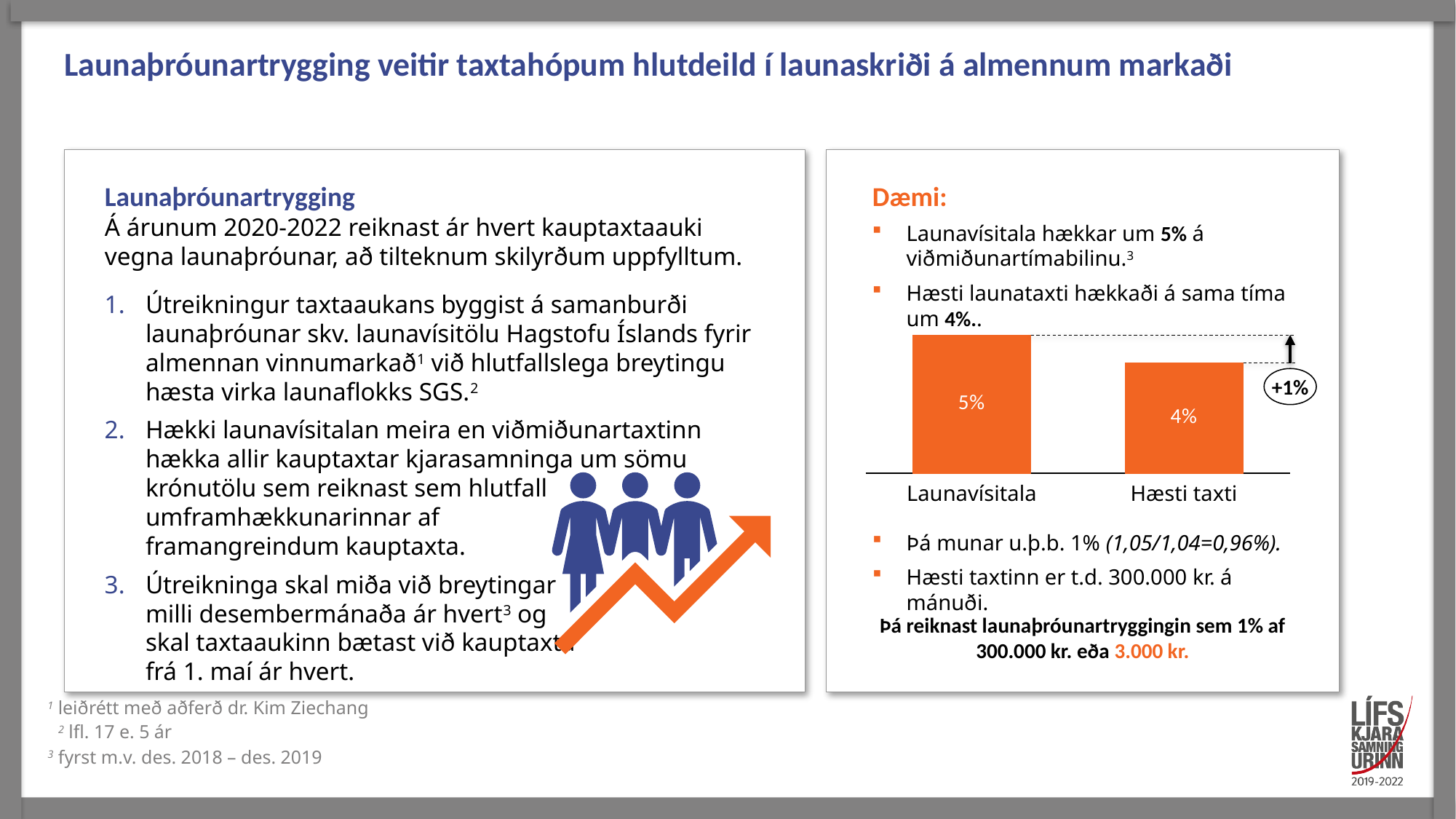
Which category has the lowest value in the bar chart? Hæsti taxti What kind of chart is shown on the slide? Bar chart What colour are the bars in the chart? Orange What is the value for Launavísitala in the bar chart? 5% Which is larger in the bar chart, Launavísitala or Hæsti taxti? Launavísitala How many categories are shown in the bar chart? 2 What is the value for Hæsti taxti in the bar chart? 4% What label is shown in the circle next to the arrow above the Hæsti taxti bar? +1% Which category has the highest value in the bar chart? Launavísitala What is the difference between the Launavísitala and Hæsti taxti values in the bar chart? 1%